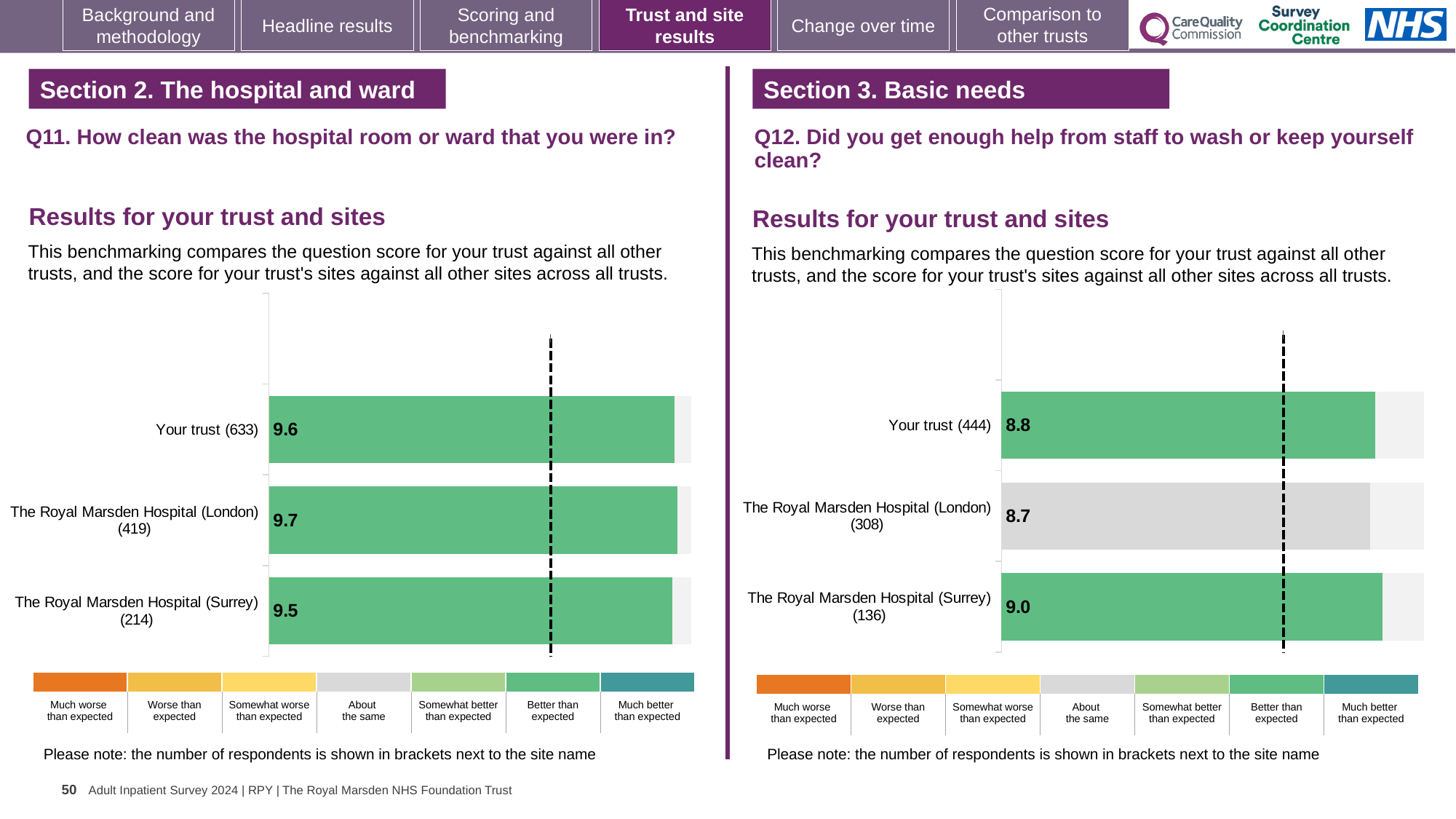
On the Q12 chart (right), which has the larger score: Your trust or The Royal Marsden Hospital (London)? Your trust On the Q11 chart (left), what is the difference between the scores for The Royal Marsden Hospital (London) and The Royal Marsden Hospital (Surrey)? 0.2 On the Q12 chart (right), what is the difference between the scores for The Royal Marsden Hospital (Surrey) and The Royal Marsden Hospital (London)? 0.3 On the Q11 chart (left), what is the score for The Royal Marsden Hospital (London) (419)? 9.7 On the Q11 chart (left), what is the score for Your trust (633)? 9.6 What type of chart is used on the Q11 chart (left)? Bar chart On the Q12 chart (right), which benchmarking category does the grey bar for The Royal Marsden Hospital (London) represent according to the legend? About the same On the Q11 chart (left), how many bars are plotted? 3 On the Q12 chart (right), which site or trust has the highest score? The Royal Marsden Hospital (Surrey) (136) On the Q12 chart (right), what is the score for Your trust (444)? 8.8 On the Q12 chart (right), what is the score for The Royal Marsden Hospital (Surrey) (136)? 9.0 On the Q11 chart (left), which site or trust has the lowest score? The Royal Marsden Hospital (Surrey) (214)